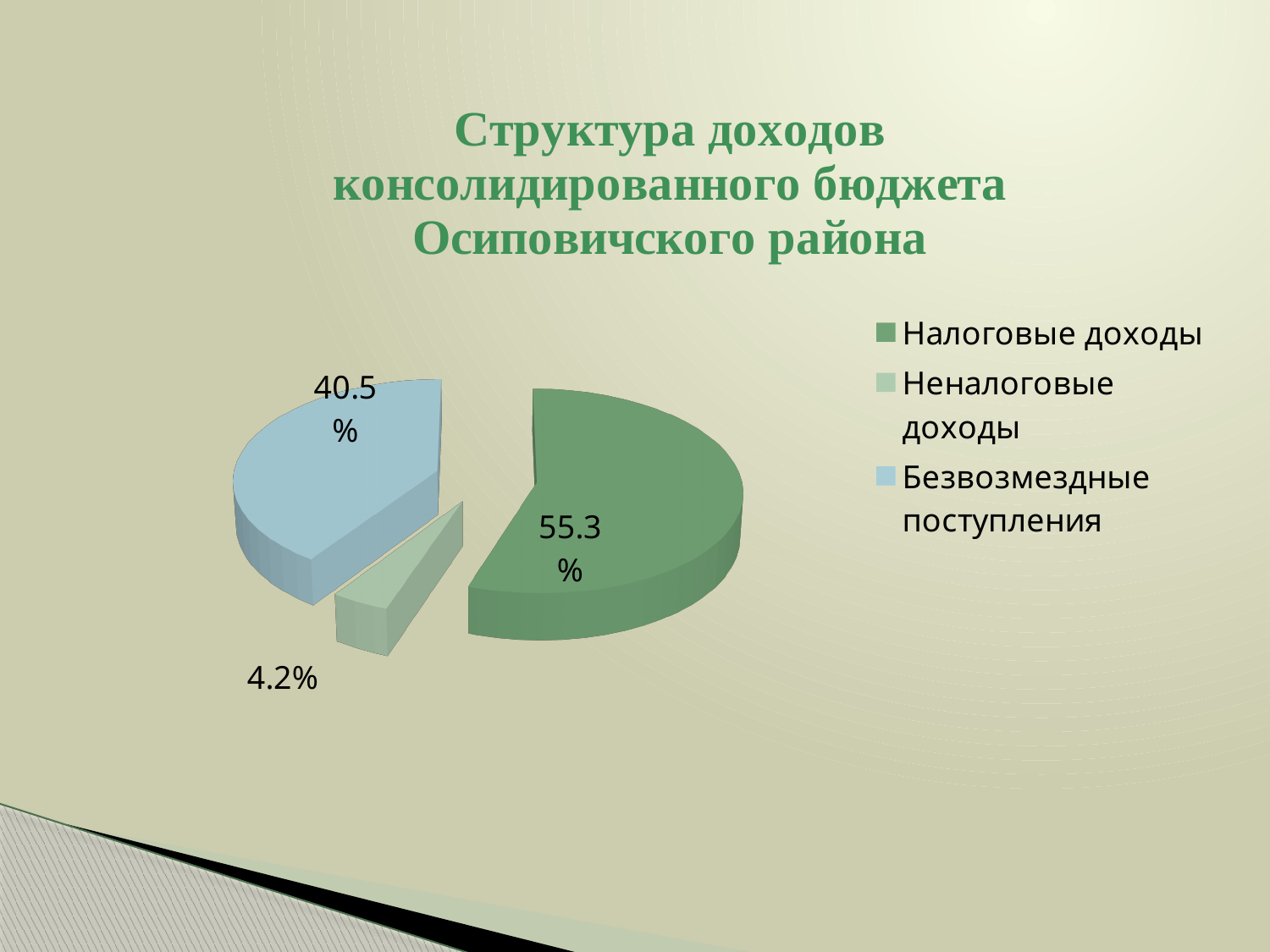
What is the title of the chart? Структура доходов консолидированного бюджета Осиповичского района What kind of chart is shown on the slide? Pie chart What share of the pie does Налоговые доходы have? 55.3% What colour is the slice for Безвозмездные поступления? Light blue What share of the pie does Безвозмездные поступления have? 40.5% Which is larger, the share for Безвозмездные поступления or the share for Неналоговые доходы? Безвозмездные поступления What is the difference in percentage points between Налоговые доходы and Безвозмездные поступления? 14.8 How many entries does the legend list? 3 What share of the pie does Неналоговые доходы have? 4.2% Which category has the largest share of the pie? Налоговые доходы Which category has the smallest share of the pie? Неналоговые доходы How many slices does the pie chart have? 3